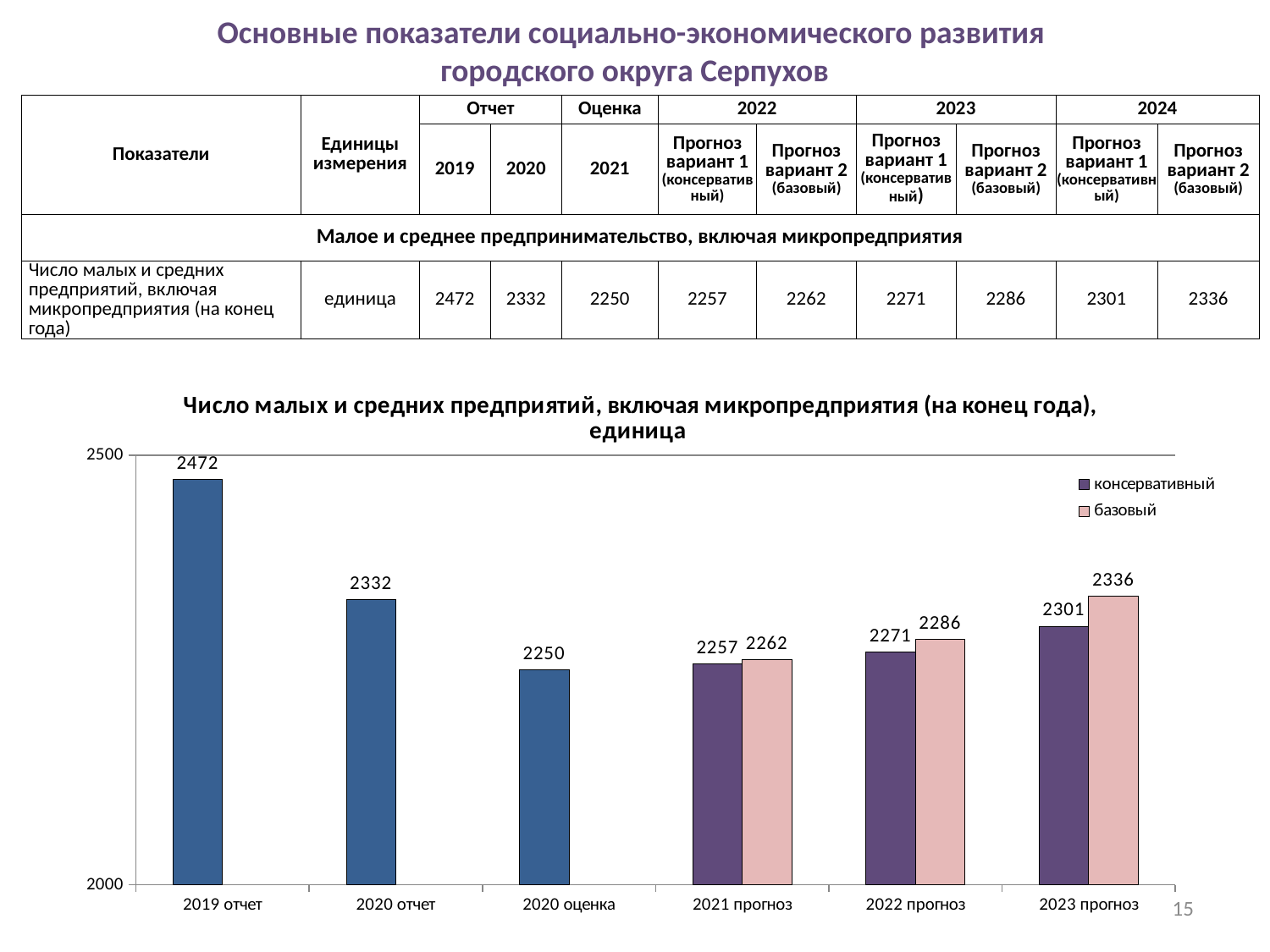
What is the difference between the "базовый" and "консервативный" values for "2023 прогноз"? 35 What is the value for "2019 отчет" in the chart? 2472 What type of chart is shown on the slide? bar chart Which category has the lowest value in the chart? 2020 оценка How many series does the chart legend list? 2 What is the difference between the values for "2019 отчет" and "2020 отчет"? 140 Which category has the highest value in the chart? 2019 отчет How many categories are shown on the x axis of the chart? 6 What is the value for "2020 оценка" in the chart? 2250 What is the "консервативный" value for "2022 прогноз" in the chart? 2271 Which is larger for "2021 прогноз": the "консервативный" or the "базовый" value? базовый What is the "базовый" value for "2023 прогноз" in the chart? 2336